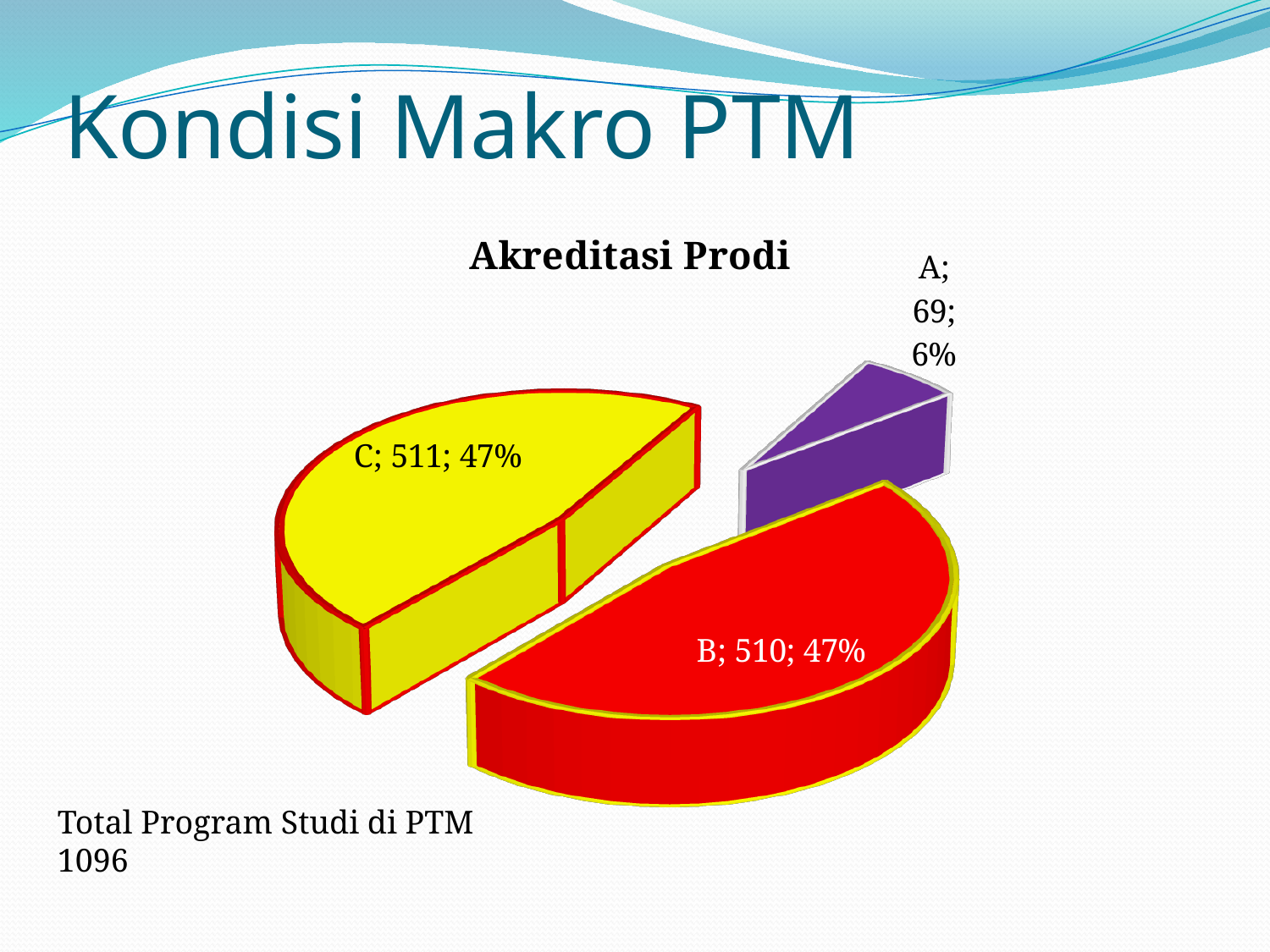
What share of the pie does slice A represent? 6% What colour is the slice for category C? yellow How many slices does the pie chart have? 3 What is the difference between the values for B and A? 441 What is the value for category B? 510 What is the value for category A? 69 Which is larger, the value for A or the value for B? B What is the title of the chart? Akreditasi Prodi What share of the pie does slice C represent? 47% What is the value for category C? 511 Which category has the smallest slice? A What kind of chart is shown on the slide? pie chart